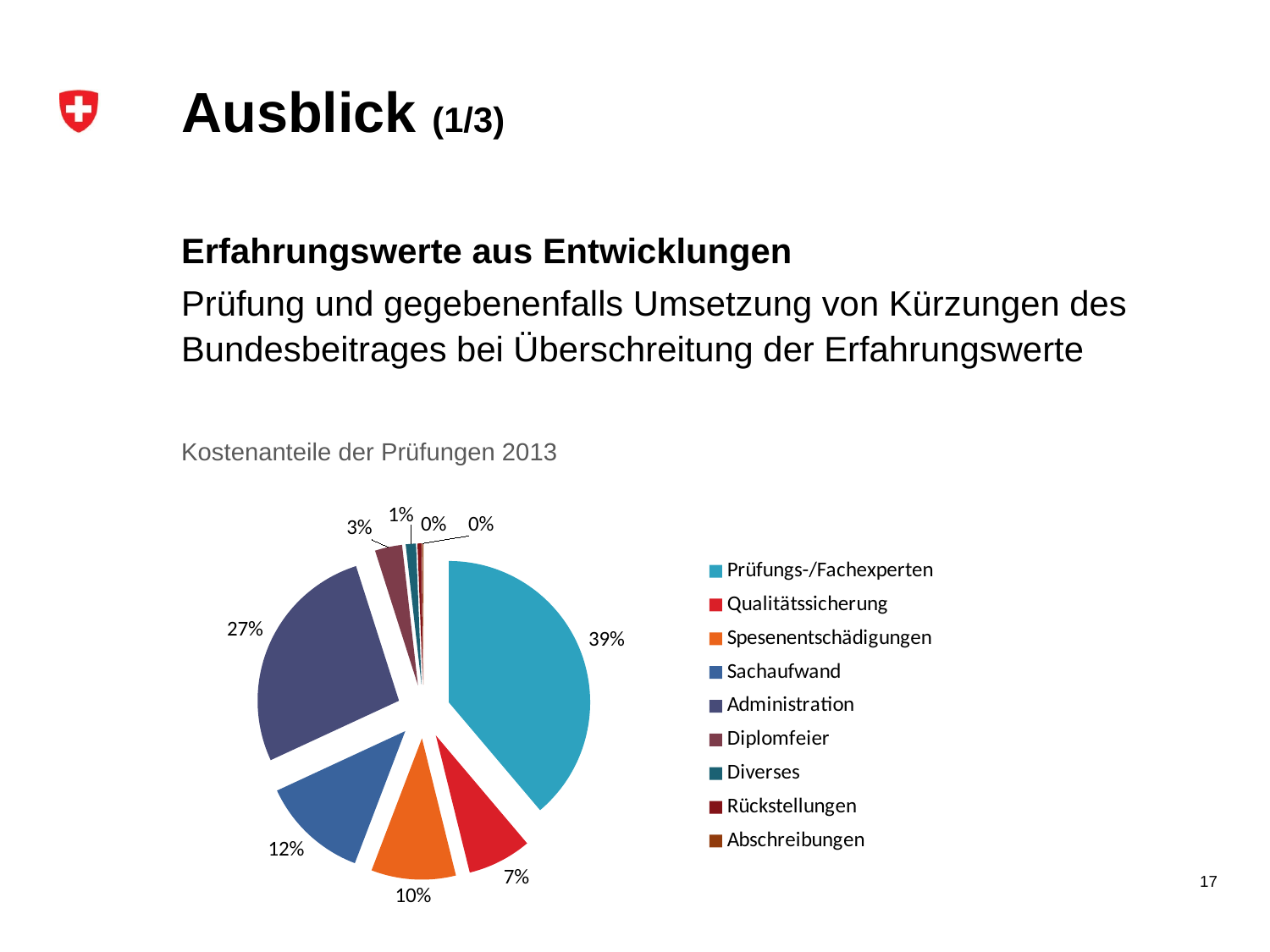
What share of the pie does Qualitätssicherung have? 7% What share of the pie does Prüfungs-/Fachexperten have? 39% What share of the pie does Sachaufwand have? 12% What kind of chart is shown on the slide? pie chart Which category has the largest share of the pie? Prüfungs-/Fachexperten How many entries does the chart's legend list? 9 What is the difference in percentage points between the shares of Prüfungs-/Fachexperten and Administration? 12 Which has the larger share, Sachaufwand or Spesenentschädigungen? Sachaufwand What is the title of the chart on the slide? Kostenanteile der Prüfungen 2013